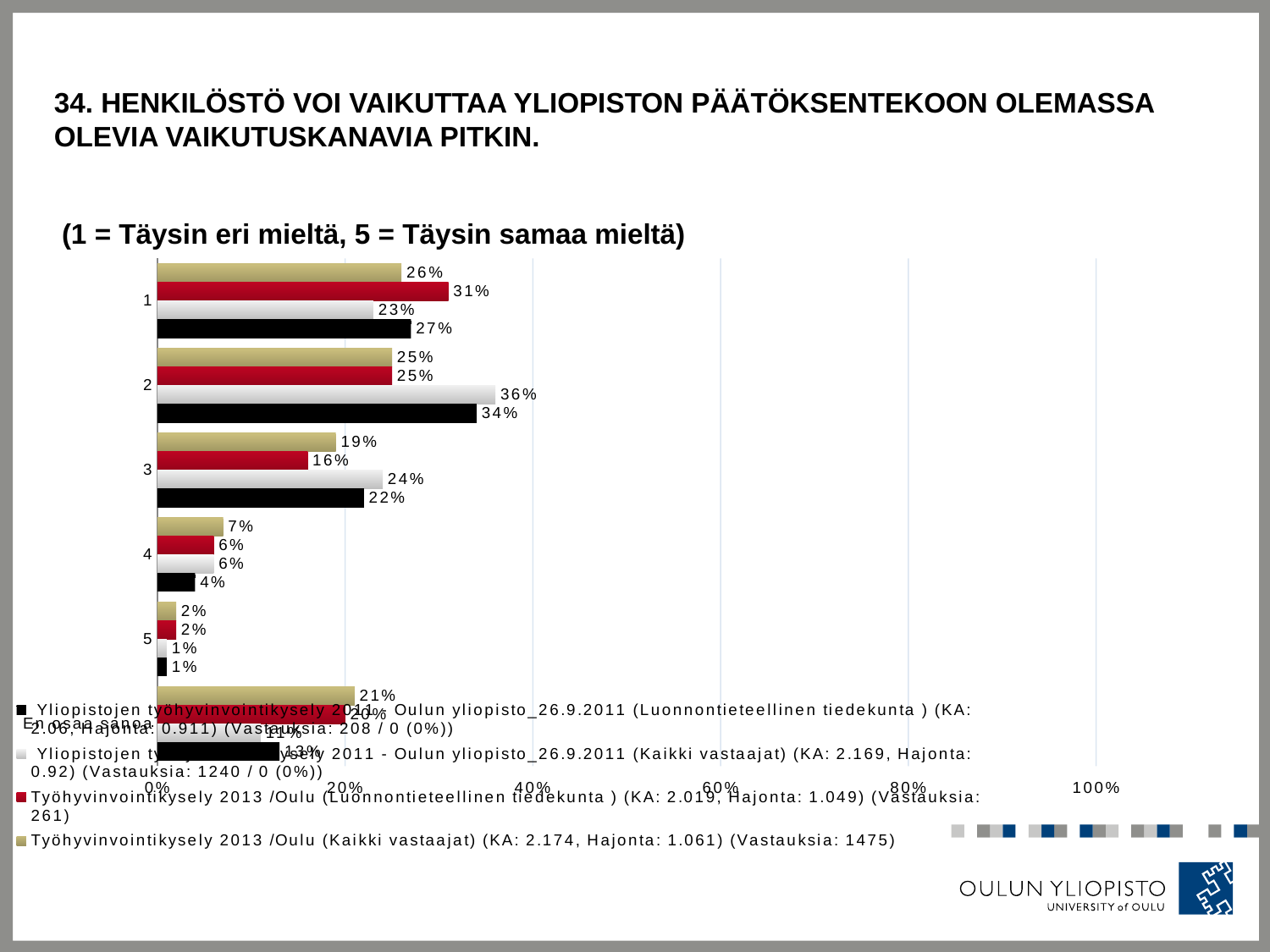
What kind of chart is shown on the slide? bar chart What is the difference between the 2011 Kaikki vastaajat (light gray) value and the 2013 Kaikki vastaajat (tan) value for category 2? 11% What is the value for category 4 in the Yliopistojen työhyvinvointikysely 2011 (Luonnontieteellinen tiedekunta) series (black bars)? 4% What is the value for category 3 in the Työhyvinvointikysely 2013 /Oulu (Kaikki vastaajat) series (tan bars)? 19% How many series does the legend list? 4 What is the scale shown on the horizontal axis, from its first to its last tick? 0% to 100% Which category has the lowest value in the Työhyvinvointikysely 2013 /Oulu (Kaikki vastaajat) series (tan bars)? 5 For category 3, which is larger: the 2011 Kaikki vastaajat (light gray) value or the 2013 Luonnontieteellinen tiedekunta (red) value? 2011 Kaikki vastaajat (light gray), 24% What is the value for category 1 in the Työhyvinvointikysely 2013 /Oulu (Luonnontieteellinen tiedekunta) series (red bars)? 31% Which category has the highest value in the Yliopistojen työhyvinvointikysely 2011 (Luonnontieteellinen tiedekunta) series (black bars)? 2 What is the value for category 2 in the Yliopistojen työhyvinvointikysely 2011 - Oulun yliopisto (Kaikki vastaajat) series (light gray bars)? 36% Is the value for category 1 in the Työhyvinvointikysely 2013 /Oulu (Luonnontieteellinen tiedekunta) series (red bars) greater or less than 20%? greater